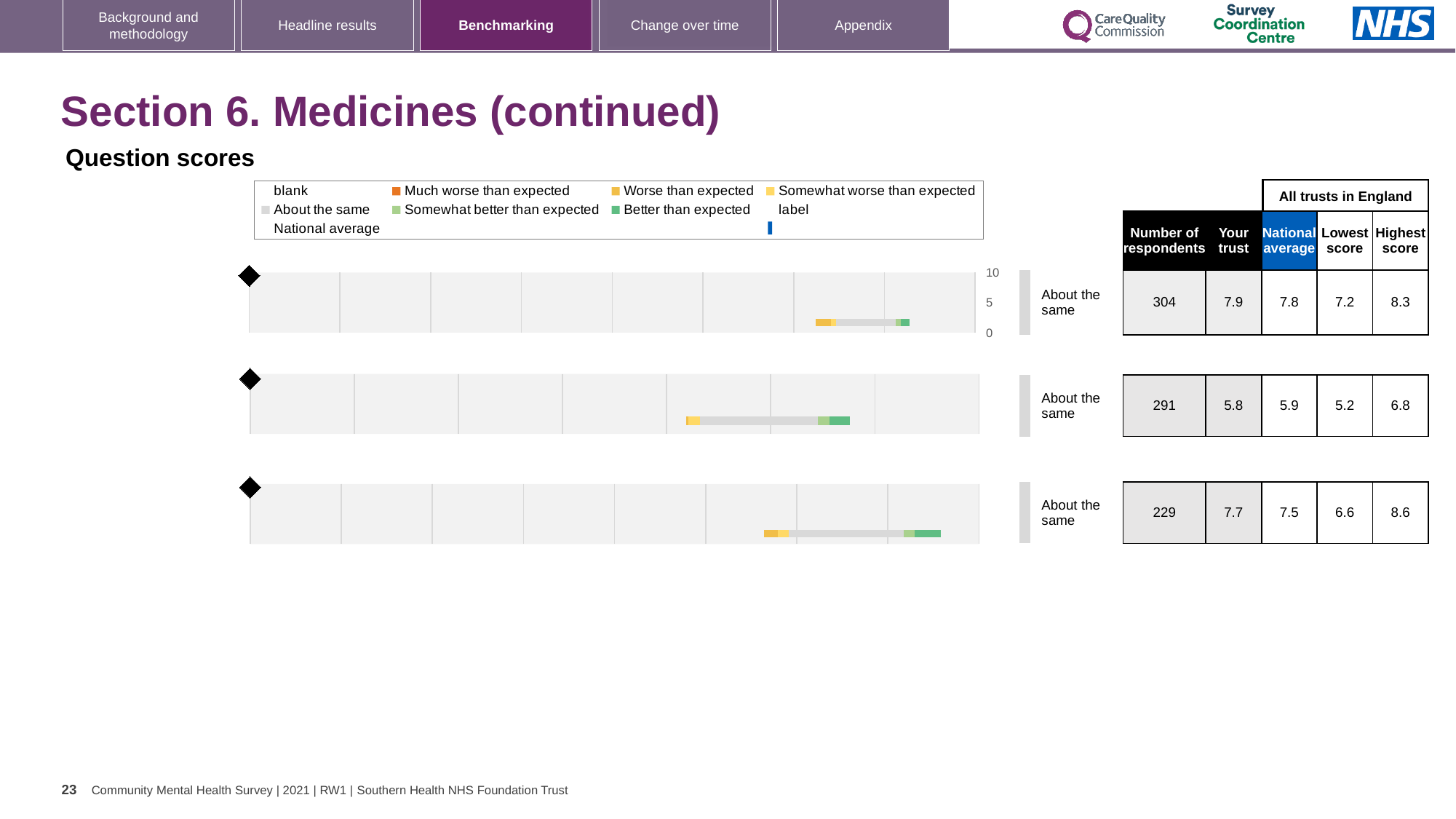
For the top chart, which is larger: the 'Your trust' score or the national average? Your trust For the middle chart, what is the lowest score among all trusts in England? 5.2 For the top chart, what is the number of respondents shown in the table? 304 For the middle chart, what is the national average score? 5.9 Which of the three charts has the lowest 'Your trust' score? the middle chart What benchmark category label is shown next to the bottom chart? About the same For the top chart, what is the 'Your trust' score? 7.9 What kind of chart is used for the three benchmarking rows on the slide? bar chart How many benchmarking charts are shown on the slide? 3 For the bottom chart, what is the difference between the highest score and the lowest score? 2.0 For the bottom chart, what is the highest score among all trusts in England? 8.6 What is the maximum value shown on the scale axis of the top chart? 10